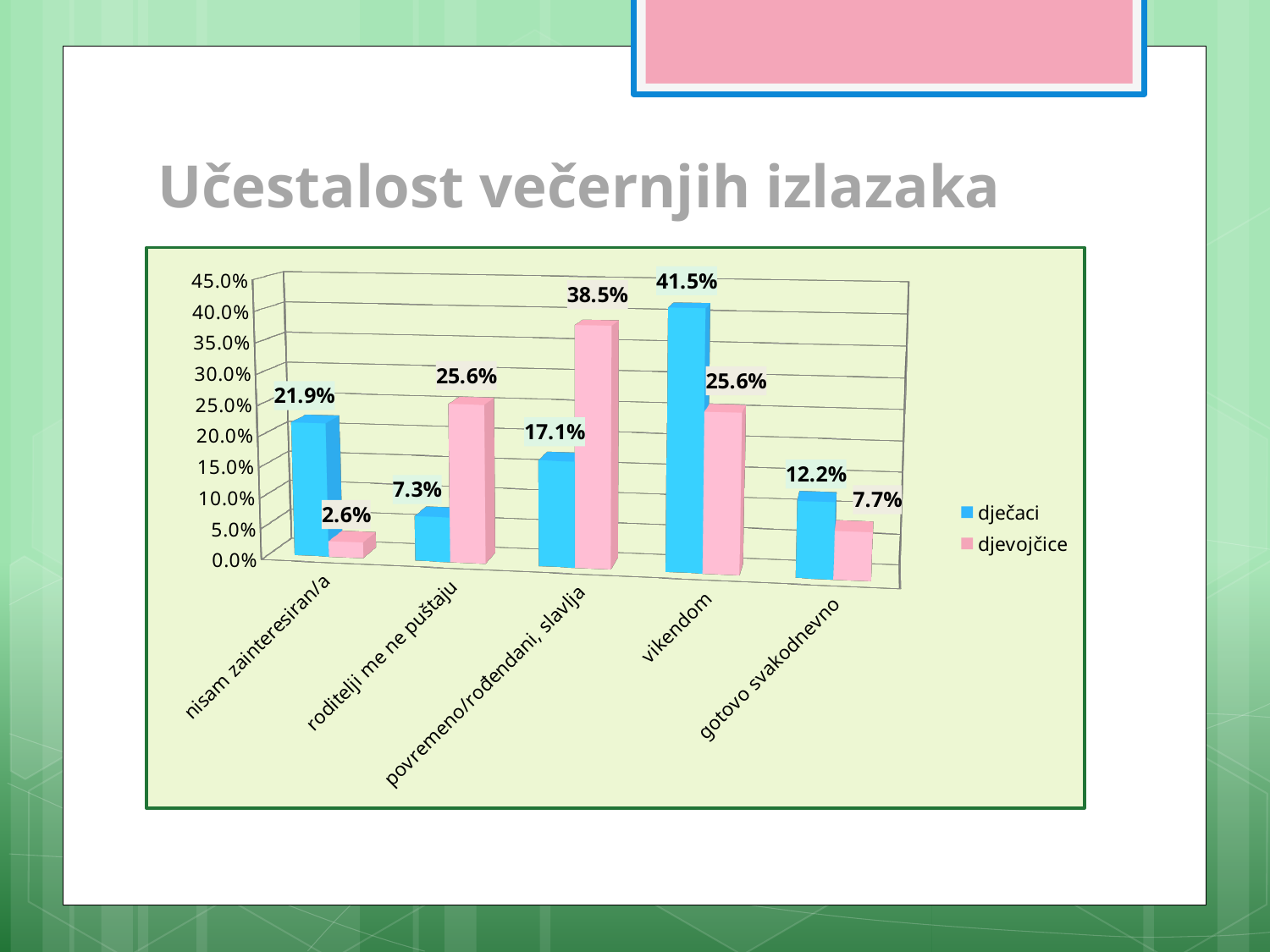
What kind of chart is shown on the slide? bar chart Which category has the highest value for dječaci? vikendom What is the value for djevojčice in the 'nisam zainteresiran/a' category? 2.6% What is the value for dječaci in the 'vikendom' category? 41.5% What is the difference between dječaci and djevojčice in the 'vikendom' category? 15.9% What is the title of the slide? Učestalost večernjih izlazaka Which colour represents the djevojčice series? pink What is the value for djevojčice in the 'povremeno/rođendani, slavlja' category? 38.5% How many series does the legend list? 2 Which category has the lowest value for djevojčice? nisam zainteresiran/a Which is larger in the 'roditelji me ne puštaju' category, dječaci or djevojčice? djevojčice How many categories are shown on the x axis? 5